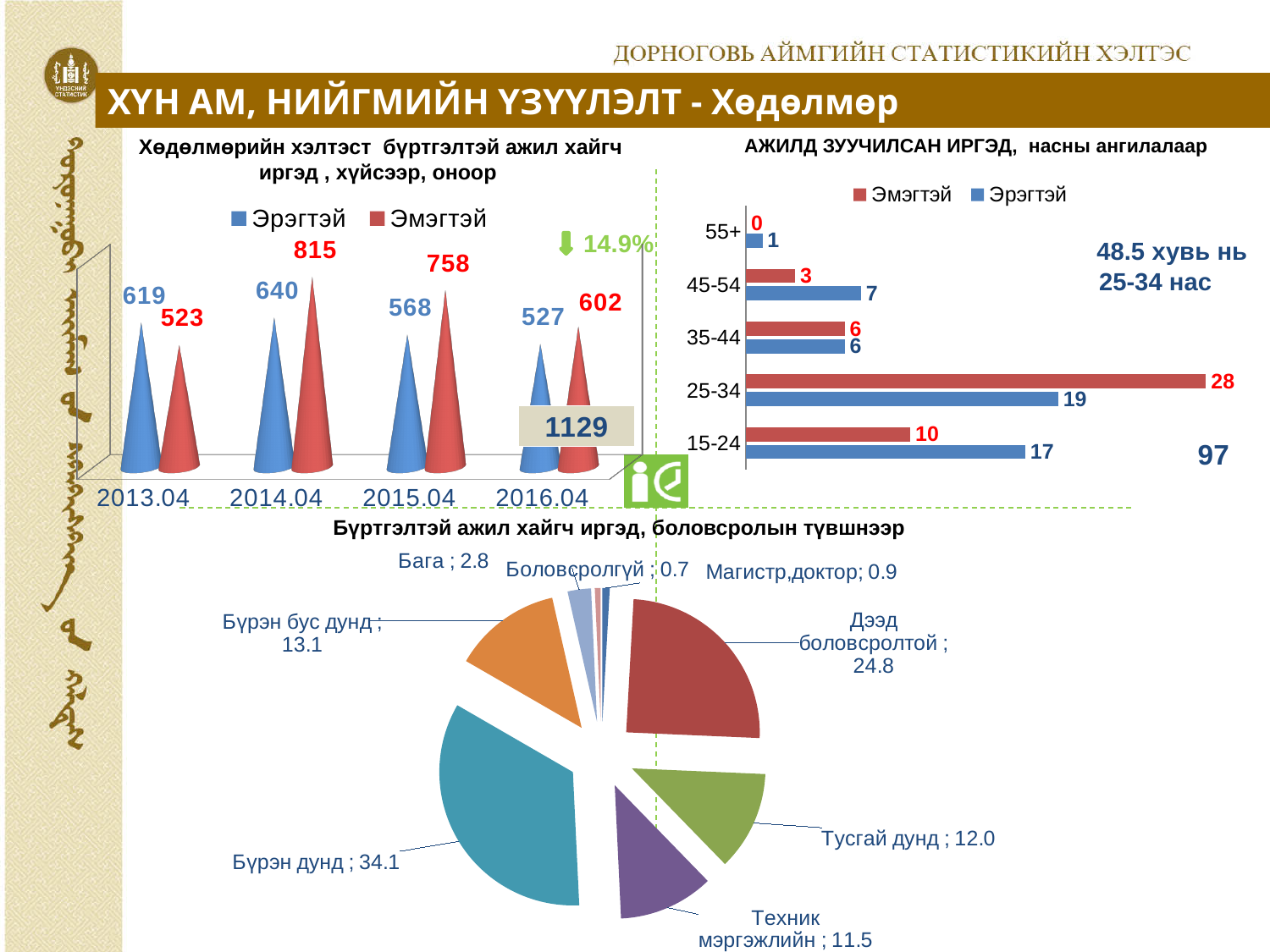
In the top-left chart, which year has the highest Эрэгтэй value? 2014.04 In the top-left chart, what is the value for Эрэгтэй in 2016.04? 527 In the top-right chart, what is the total of Эмэгтэй and Эрэгтэй for the 15-24 age group? 27 In the top-left chart, how many series does the legend list? 2 In the top-left chart (Хөдөлмөрийн хэлтэст бүртгэлтэй ажил хайгч иргэд), what is the value for Эмэгтэй in 2014.04? 815 In the top-right chart, how many age groups are shown? 5 In the top-right chart (АЖИЛД ЗУУЧИЛСАН ИРГЭД, насны ангилалаар), what is the Эмэгтэй value for the 25-34 age group? 28 In the top-left chart, what is the difference between the Эмэгтэй and Эрэгтэй values in 2015.04? 190 In the top-right chart, which age group has the highest Эрэгтэй value? 25-34 In the bottom pie chart, which category has the smallest value? Боловсролгүй In the bottom pie chart, what is the value for Бүрэн дунд? 34.1 In the bottom chart (Бүртгэлтэй ажил хайгч иргэд, боловсролын түвшнээр), what kind of chart is it? Pie chart